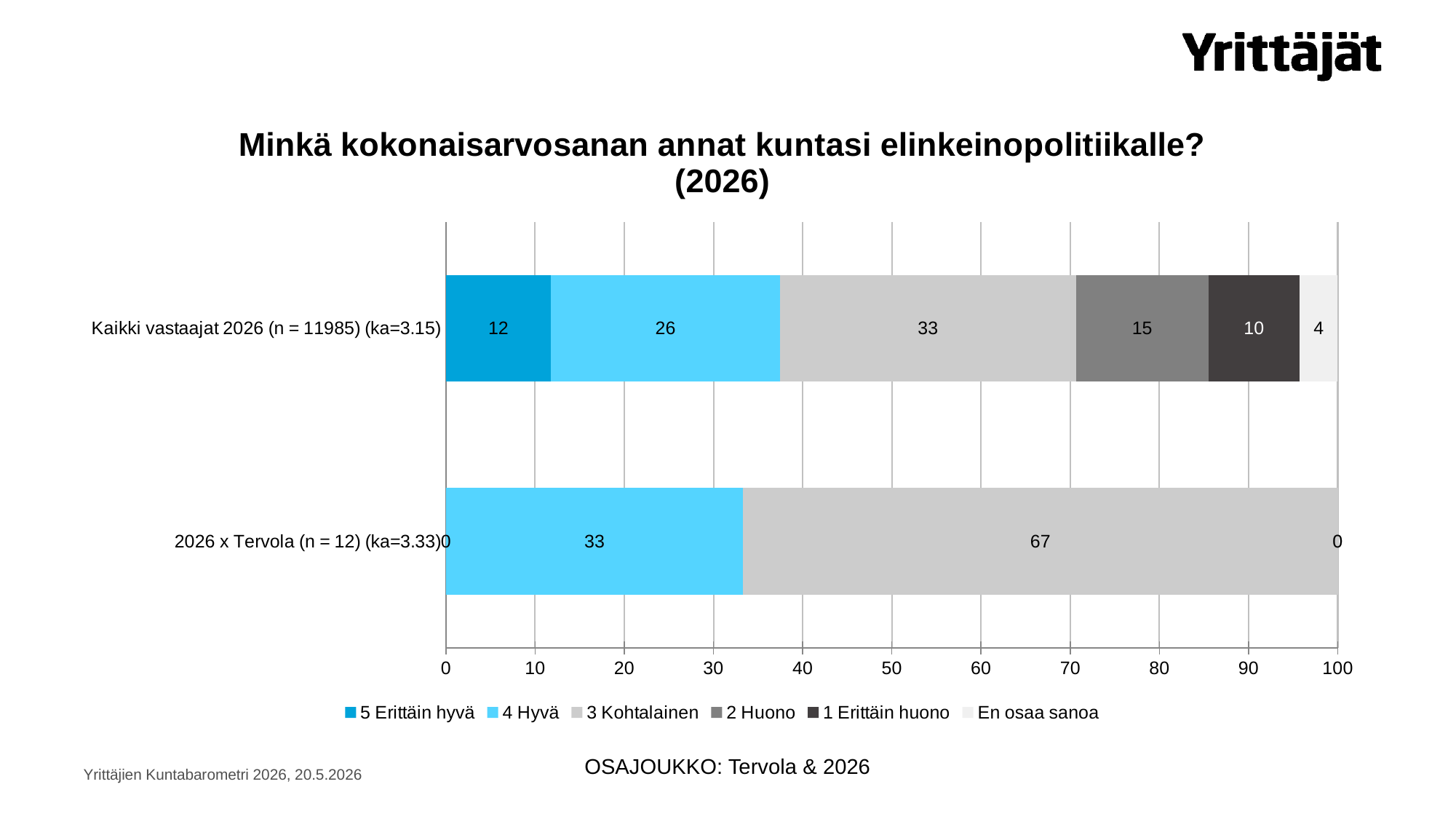
What is the difference between the "3 Kohtalainen" values of the "2026 x Tervola (n = 12) (ka=3.33)" bar and the "Kaikki vastaajat 2026 (n = 11985) (ka=3.15)" bar? 34 Which is larger: the "4 Hyvä" value for "Kaikki vastaajat 2026 (n = 11985) (ka=3.15)" or for "2026 x Tervola (n = 12) (ka=3.33)"? 2026 x Tervola (n = 12) (ka=3.33) What is the value for "3 Kohtalainen" in the "2026 x Tervola (n = 12) (ka=3.33)" bar? 67 Which segment is the smallest in the "Kaikki vastaajat 2026 (n = 11985) (ka=3.15)" bar? En osaa sanoa How many series does the legend list? 6 What is the value for "5 Erittäin hyvä" in the "Kaikki vastaajat 2026 (n = 11985) (ka=3.15)" bar? 12 How many bars (categories) are shown in the chart? 2 What is the value for "3 Kohtalainen" in the "Kaikki vastaajat 2026 (n = 11985) (ka=3.15)" bar? 33 What is the value for "En osaa sanoa" in the "Kaikki vastaajat 2026 (n = 11985) (ka=3.15)" bar? 4 What is the value for "4 Hyvä" in the "2026 x Tervola (n = 12) (ka=3.33)" bar? 33 What kind of chart is shown on the slide? stacked bar chart Which segment is the largest in the "Kaikki vastaajat 2026 (n = 11985) (ka=3.15)" bar? 3 Kohtalainen